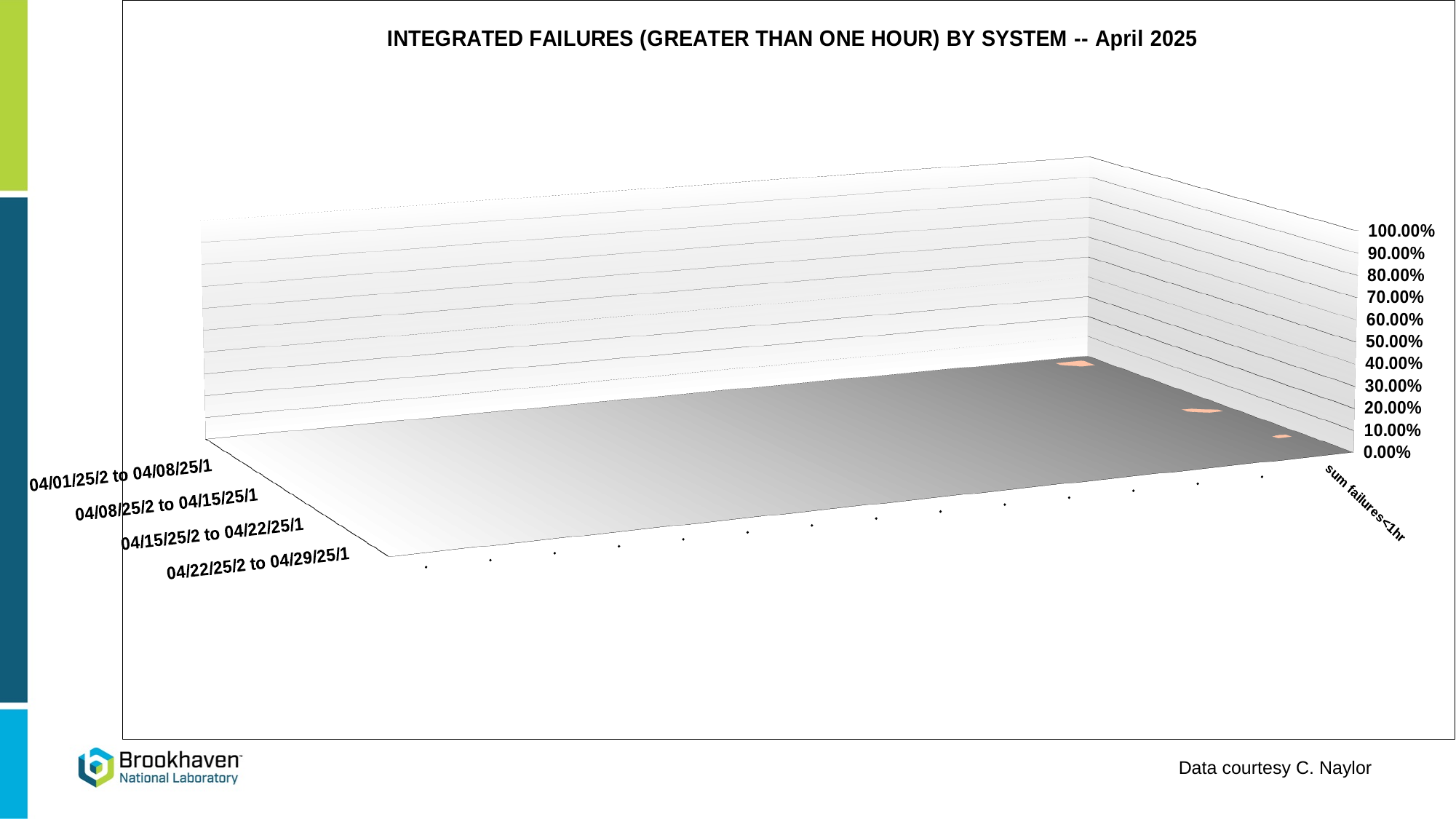
What is the title of the chart? INTEGRATED FAILURES (GREATER THAN ONE HOUR) BY SYSTEM -- April 2025 Is any plotted value in the chart greater or less than 50.00%? less Is any plotted value in the chart greater or less than 20.00%? less What is the highest tick value shown on the vertical axis of the chart? 100.00% How many tick labels are shown on the vertical axis of the chart? 11 How many date-range categories are listed along the depth axis of the chart? 4